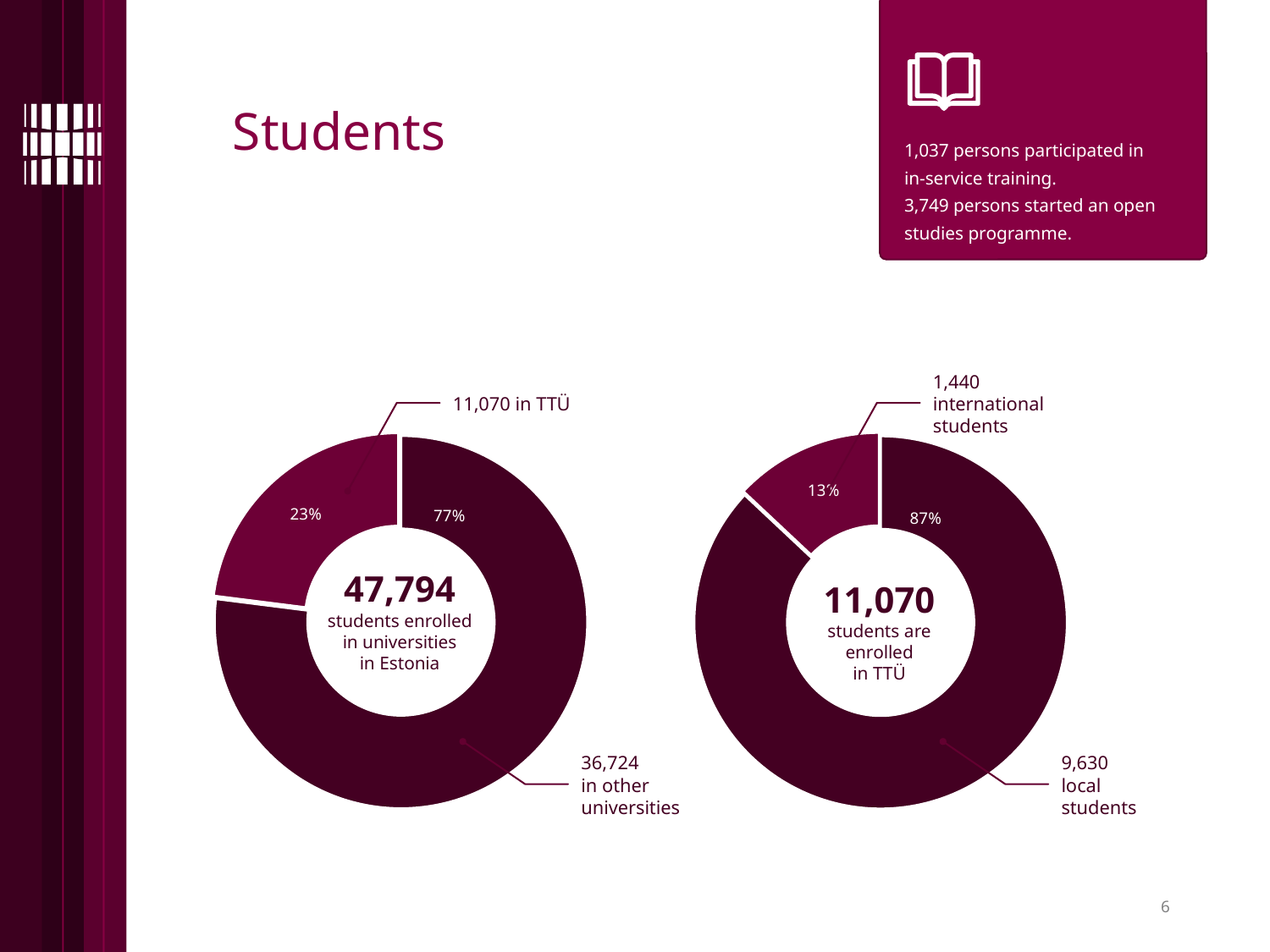
On the left chart, which slice is larger: students in TTÜ or students in other universities? Students in other universities On the left chart, what share of students enrolled in universities in Estonia are in TTÜ? 23% What is the total number of students enrolled in universities in Estonia shown in the centre of the left chart? 47,794 On the left chart, how many students are enrolled in TTÜ? 11,070 On the left chart, how many students are in other universities? 36,724 What kind of chart is used on the right side of the slide? Donut (pie) chart On the right chart, what share of TTÜ students are local students? 87% How many slices does the right chart have? 2 On the left chart, what share of students are in other universities? 77% On the right chart, how many international students are enrolled in TTÜ? 1,440 On the right chart, how many local students are enrolled in TTÜ? 9,630 On the right chart, what is the difference between the number of local students and international students? 8,190